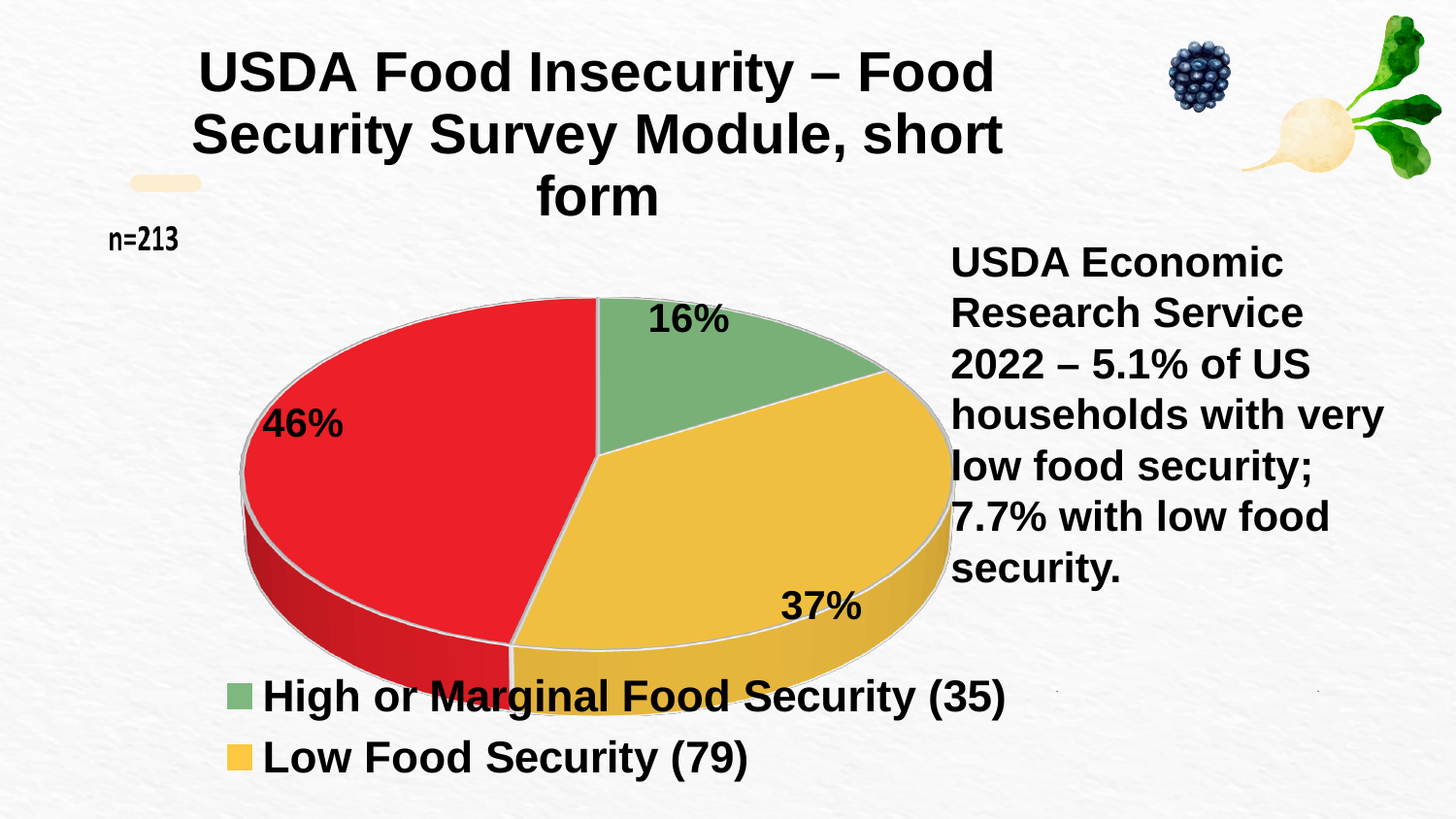
What is the difference in percentage points between the largest slice (46%) and the Low Food Security slice? 9 What is the percentage shown on the largest slice of the pie? 46% What is the difference in percentage points between the Low Food Security slice and the High or Marginal Food Security slice? 21 How many slices does the pie chart have? 3 What colour is the slice for High or Marginal Food Security? green What percentage of the pie is labelled for Low Food Security? 37% Which legend category has the smallest slice of the pie? High or Marginal Food Security (35) Which is larger, the slice for Low Food Security or the slice for High or Marginal Food Security? Low Food Security What sample size (n) is shown on the slide for the chart? n=213 What percentage of the pie is labelled for High or Marginal Food Security? 16% What type of chart is shown on the slide? pie chart What count is shown in the legend for Low Food Security? 79